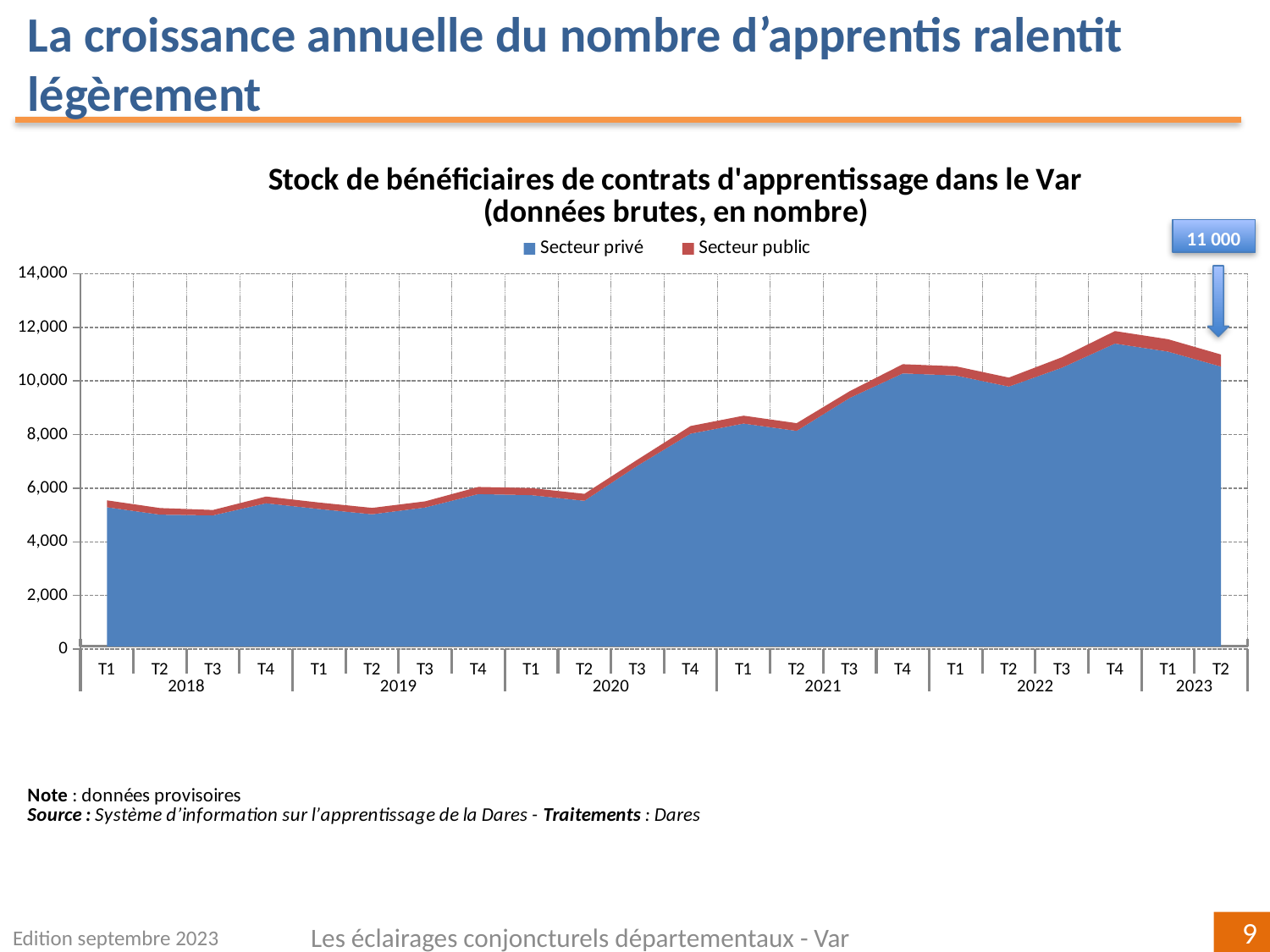
Is the total value for T1 2021 greater or less than 8,000? greater How many quarterly points are plotted along the x axis? 22 Overall, do the values rise or fall from T1 2018 to T2 2023? rise In which quarter does the total stock of apprentices reach its highest level? T4 2022 Is the total value for T4 2022 greater or less than 10,000? greater Which is larger, the total for T4 2022 or the total for T2 2023? T4 2022 Which two series are shown in the legend? Secteur privé and Secteur public Is the total value for T1 2018 greater or less than 6,000? less What total value does the callout indicate for T2 2023? 11 000 What kind of chart is shown on the slide? Stacked area chart Which colour represents the Secteur privé series? Blue How many series does the legend list? 2